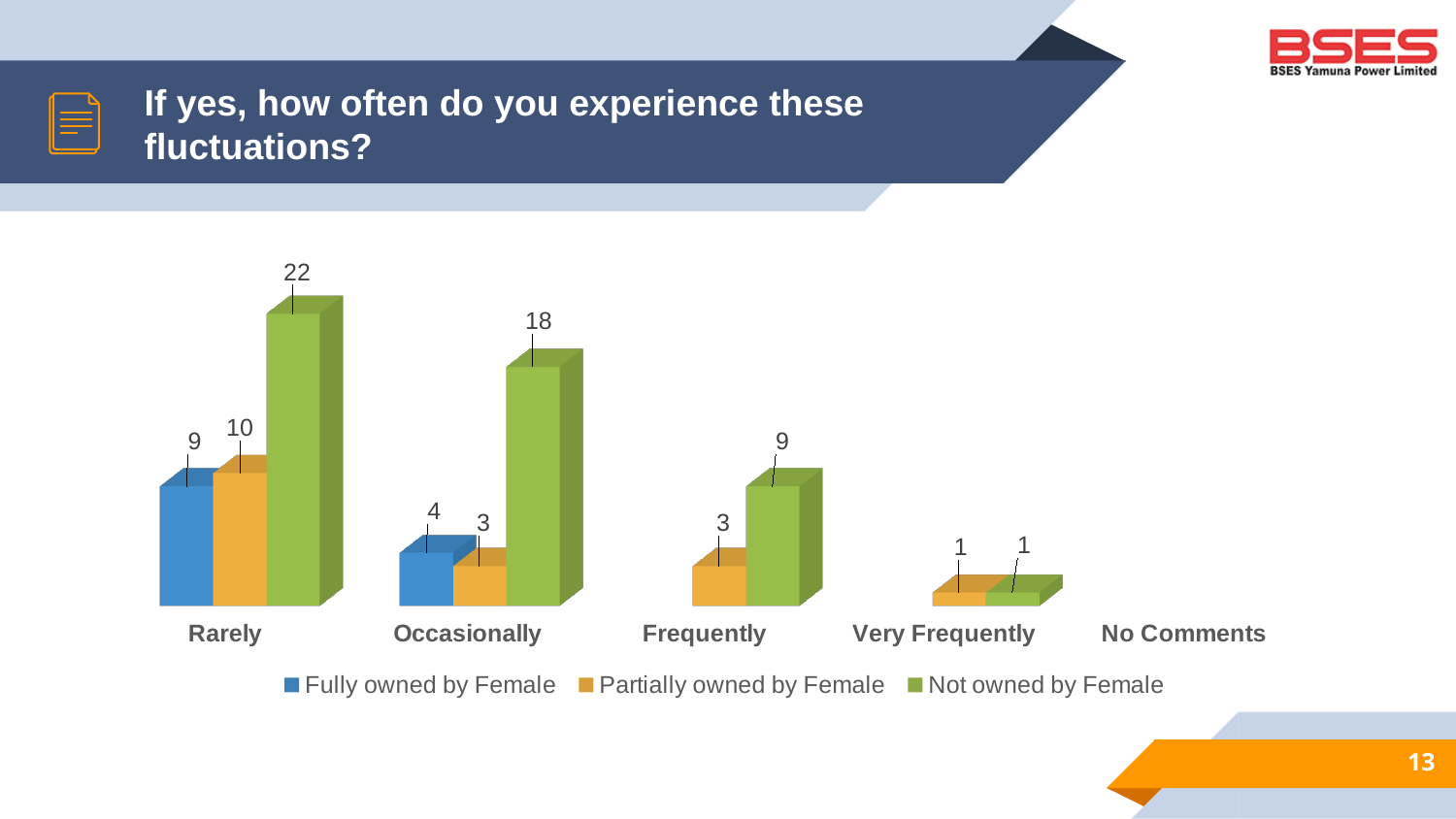
Which colour represents the Not owned by Female series? Green What is the difference between Not owned by Female in Rarely and Not owned by Female in Occasionally? 4 What is the value for Fully owned by Female in the Occasionally category? 4 Which is larger in the Occasionally category: Fully owned by Female or Partially owned by Female? Fully owned by Female What is the value for Not owned by Female in the Rarely category? 22 How many categories are shown on the x axis? 5 What is the value for Not owned by Female in the Frequently category? 9 What kind of chart is shown on the slide? Bar chart What is the value for Partially owned by Female in the Rarely category? 10 Which category has the highest value for Not owned by Female? Rarely What is the difference between Not owned by Female and Fully owned by Female in the Rarely category? 13 How many series does the legend list? 3